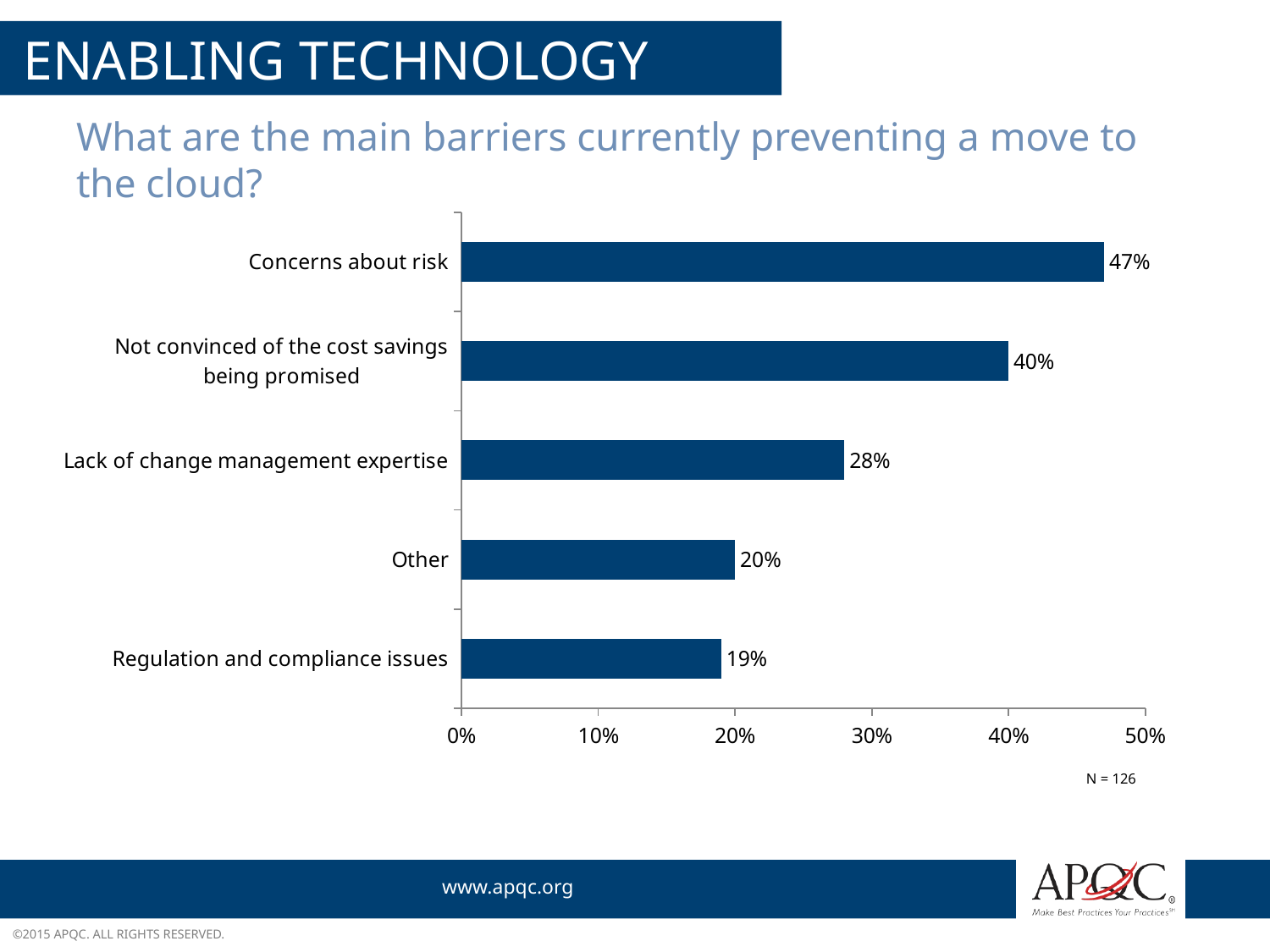
What percentage is shown for "Regulation and compliance issues"? 19% Which is larger: the value for "Other" or the value for "Regulation and compliance issues"? Other How many barrier categories are shown in the chart? 5 What is the value for "Lack of change management expertise"? 28% What is the value for "Not convinced of the cost savings being promised"? 40% Which barrier has the highest percentage? Concerns about risk Which barrier has the lowest percentage? Regulation and compliance issues What percentage of respondents cited "Concerns about risk" as a barrier to moving to the cloud? 47% What is the difference between "Lack of change management expertise" and "Other"? 8 percentage points What type of chart is used on this slide? Bar chart What is the sample size (N) noted below the chart? N = 126 What is the difference in percentage points between "Concerns about risk" and "Not convinced of the cost savings being promised"? 7 percentage points